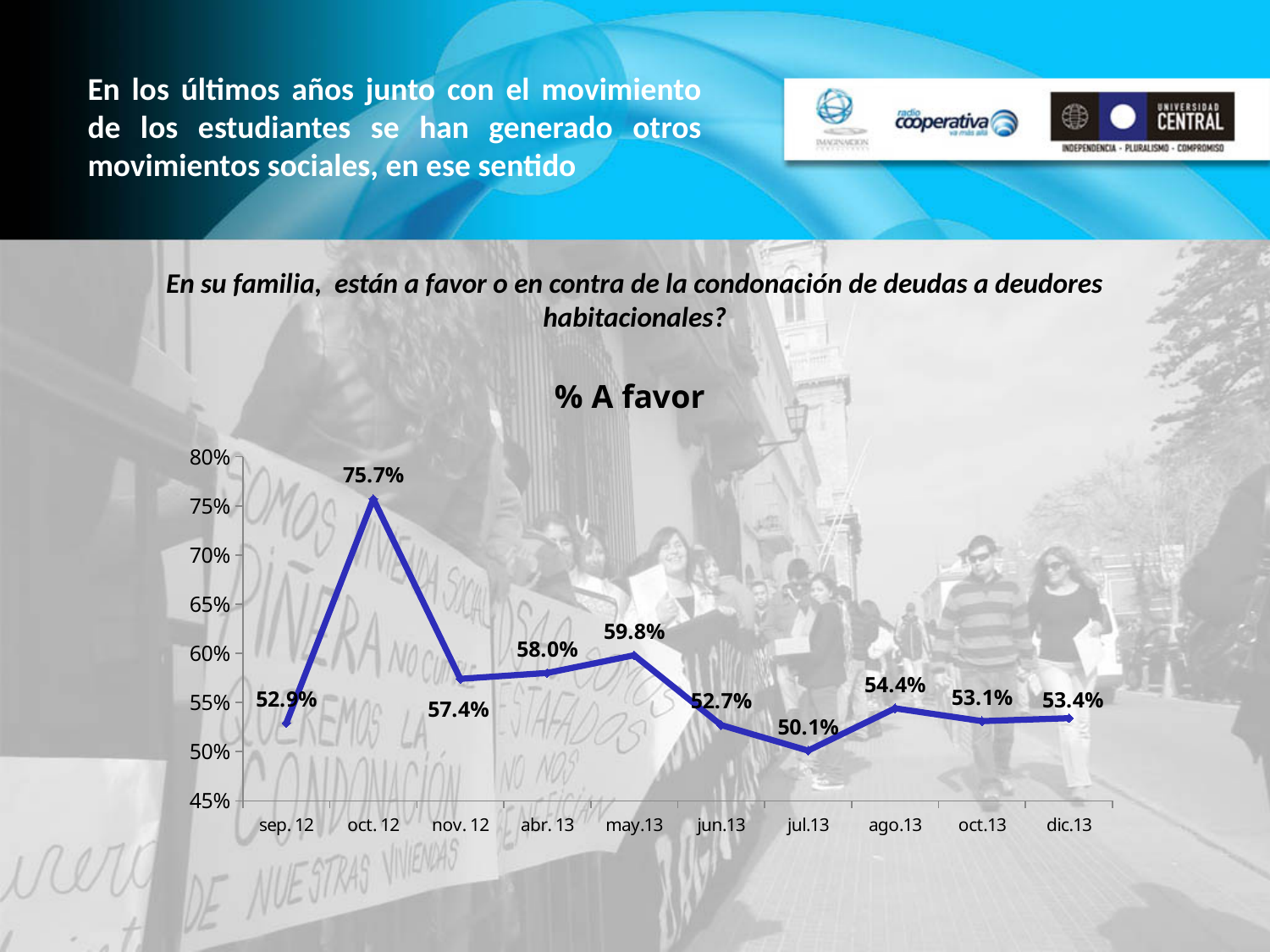
Which is larger, the value for abr. 13 or the value for jun.13? abr. 13 What kind of chart is shown on the slide? line chart What is the value for dic.13? 53.4% What is the value for may.13? 59.8% What is the difference between the values for oct. 12 and nov. 12? 18.3% Which period has the highest value? oct. 12 What is the title of the chart? % A favor How many data points are plotted on the chart? 10 What is the value for jul.13? 50.1% Is the value for ago.13 greater or less than 60%? less Which period has the lowest value? jul.13 What is the value for oct. 12? 75.7%